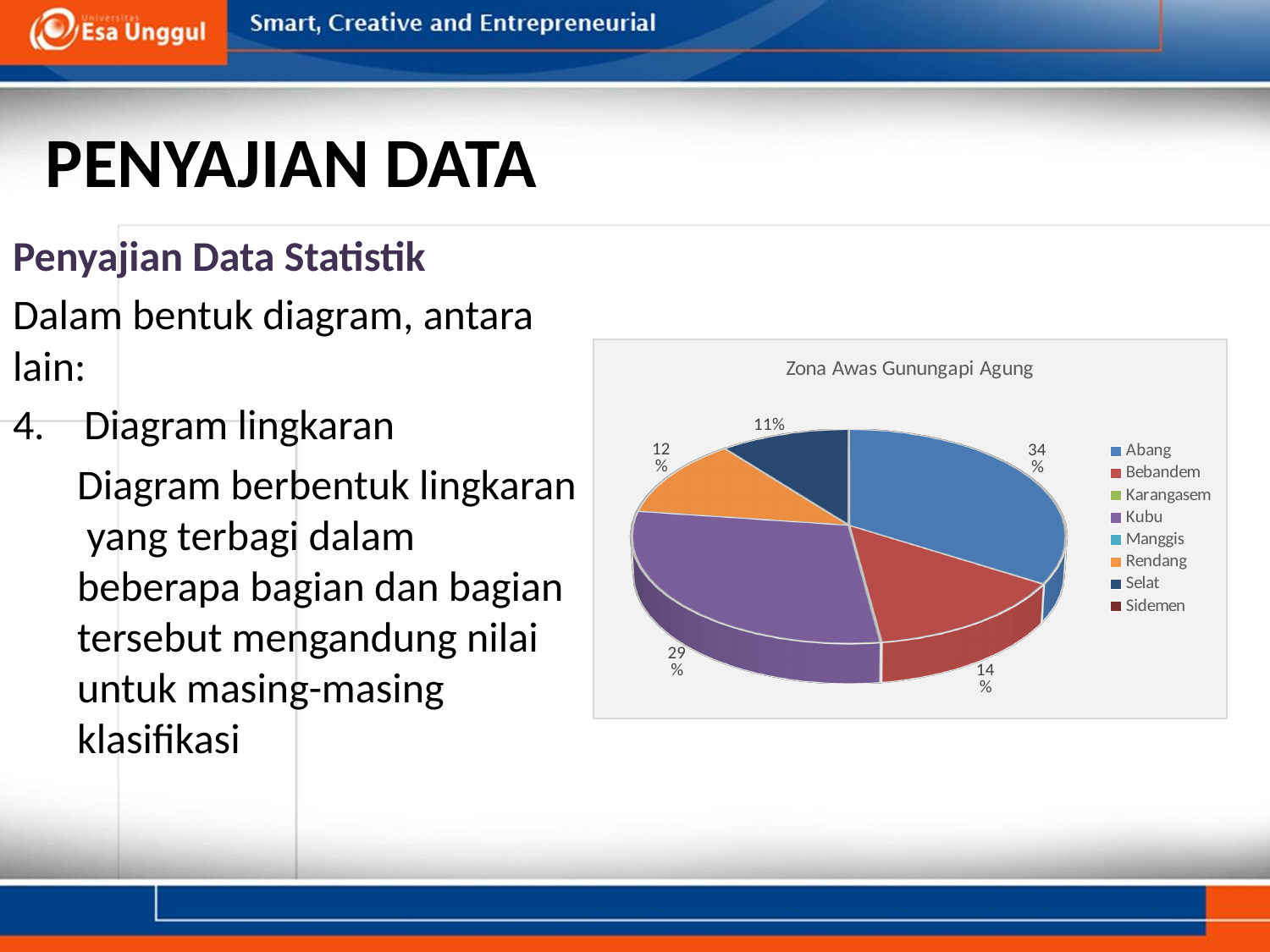
Which is larger, the slice for Kubu or the slice for Bebandem? Kubu What kind of chart is shown on the slide? pie chart How many slices in the pie have a percentage label? 5 What share of the pie does Abang have? 34% Which category has the largest slice of the pie? Abang What share of the pie does Kubu have? 29% What is the title of the chart? Zona Awas Gunungapi Agung What is the difference in percentage points between Abang and Kubu? 5% What percentage is shown for Bebandem? 14% How many entries does the chart's legend list? 8 What percentage is shown for Selat? 11% What percentage is shown for Rendang? 12%